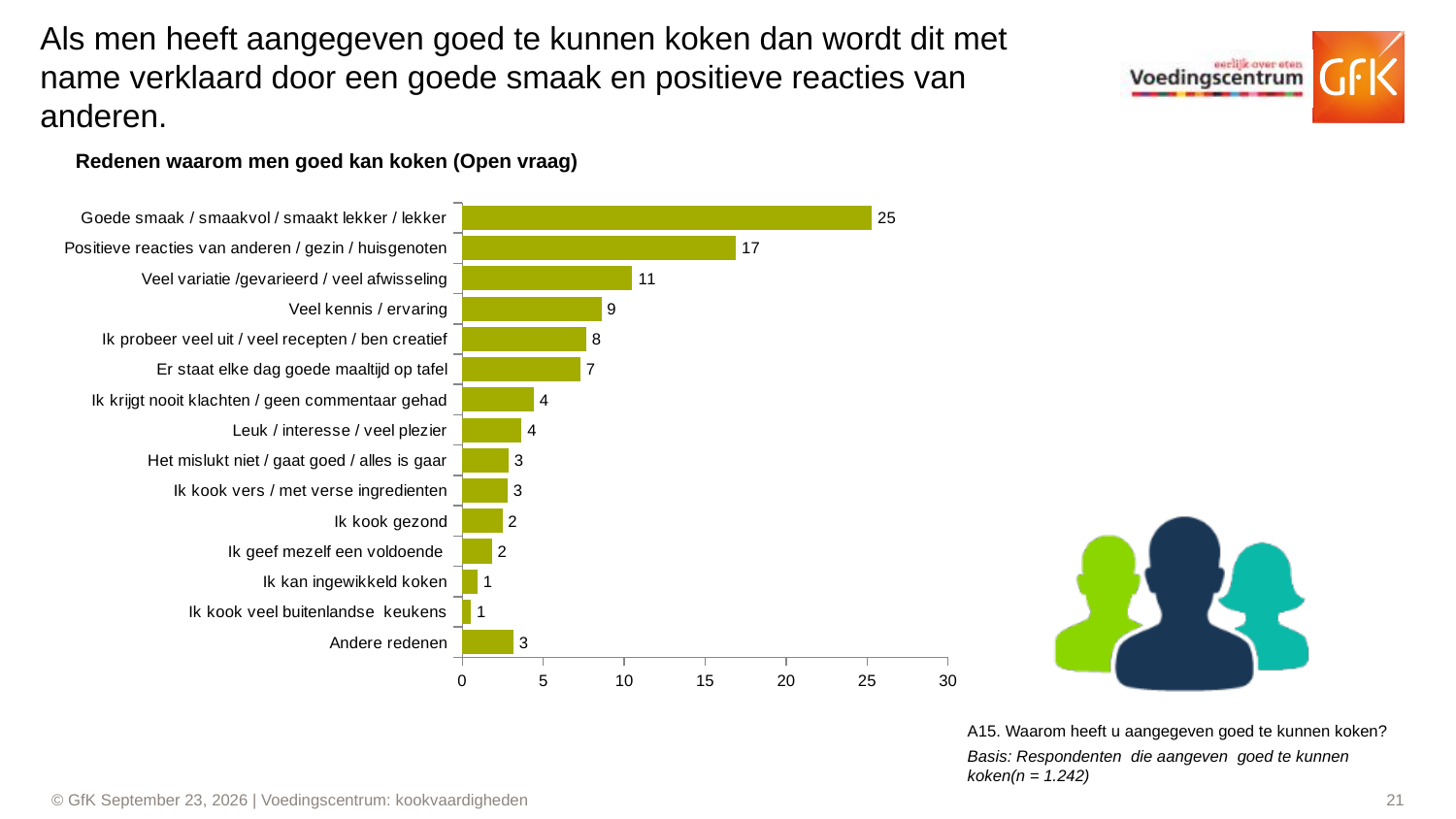
What is the value for 'Andere redenen'? 3 What is the value for 'Positieve reacties van anderen / gezin / huisgenoten'? 17 What is the difference between 'Veel variatie /gevarieerd / veel afwisseling' and 'Er staat elke dag goede maaltijd op tafel'? 4 What is the value for 'Goede smaak / smaakvol / smaakt lekker / lekker'? 25 What is the value for 'Veel kennis / ervaring'? 9 Which is larger: 'Ik probeer veel uit / veel recepten / ben creatief' or 'Ik kook gezond'? Ik probeer veel uit / veel recepten / ben creatief Is the value for 'Positieve reacties van anderen / gezin / huisgenoten' greater or less than 15? greater How many categories are shown in the chart? 15 What is the title of the chart? Redenen waarom men goed kan koken (Open vraag) Which category has the highest value? Goede smaak / smaakvol / smaakt lekker / lekker What is the difference between 'Goede smaak / smaakvol / smaakt lekker / lekker' and 'Positieve reacties van anderen / gezin / huisgenoten'? 8 What kind of chart is shown on the slide? bar chart